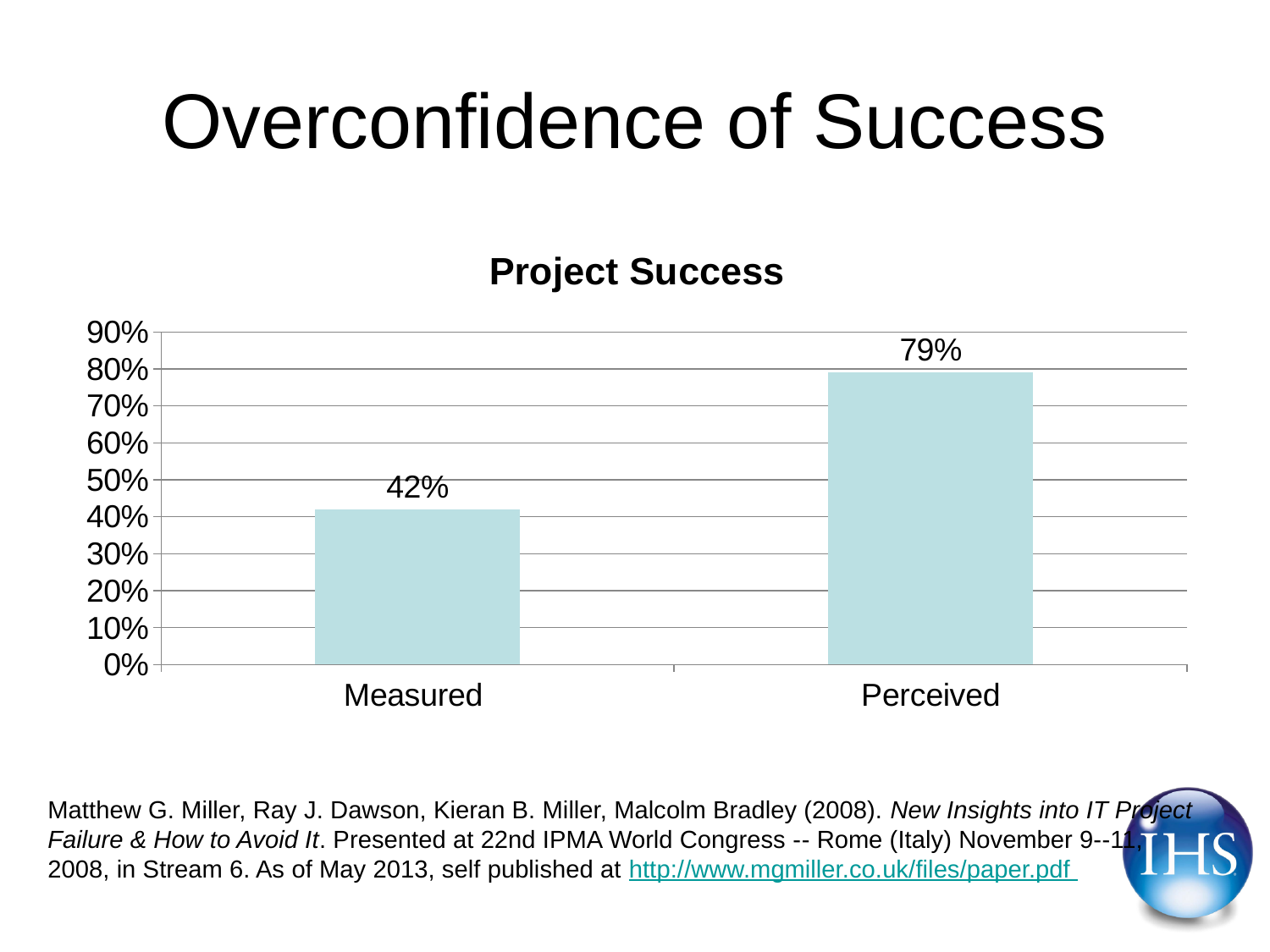
How many categories are shown in the chart? 2 Which category has the highest value? Perceived What is the difference between the Perceived and Measured values? 37% Is the value for Perceived greater or less than 70%? greater What is the title of the chart? Project Success Which is larger, the value for Measured or the value for Perceived? Perceived What kind of chart is shown on the slide? bar chart What is the value for Measured? 42% Which category has the lowest value? Measured What is the highest value shown on the vertical axis? 90% What is the value for Perceived? 79% Is the value for Measured greater or less than 50%? less